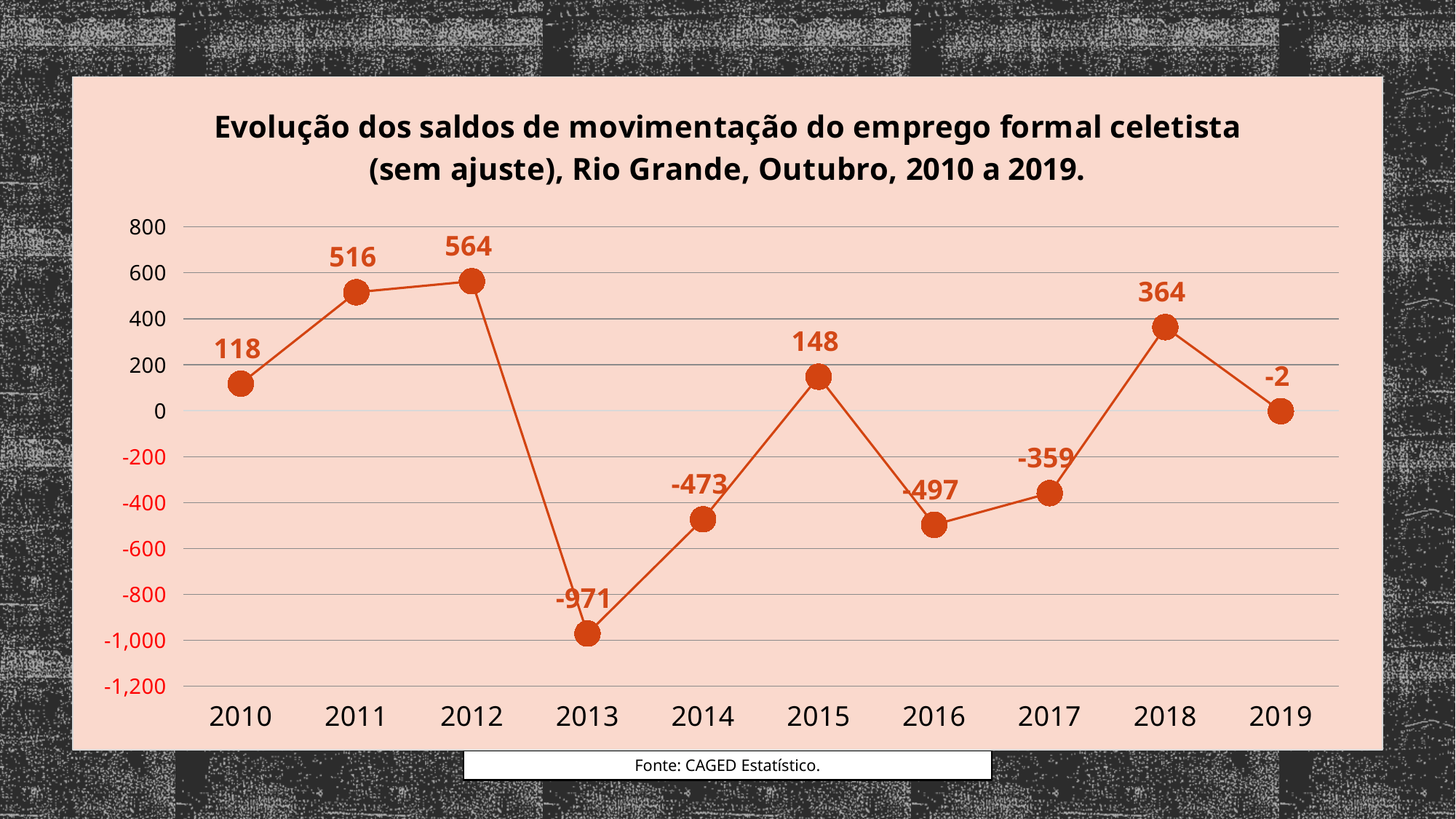
How many years are plotted on the chart? 10 What is the difference between the values for 2016 and 2014? 24 What kind of chart is shown on the slide? line chart What is the value for 2019? -2 Do the values rise or fall from 2016 to 2018? rise Which year has the lowest value? 2013 What is the value for 2013? -971 Is the value for 2013 greater or less than -800? less Which is larger, the value for 2010 or the value for 2015? 2015 What is the difference between the values for 2012 and 2011? 48 What is the value for 2018? 364 Which year has the highest value? 2012